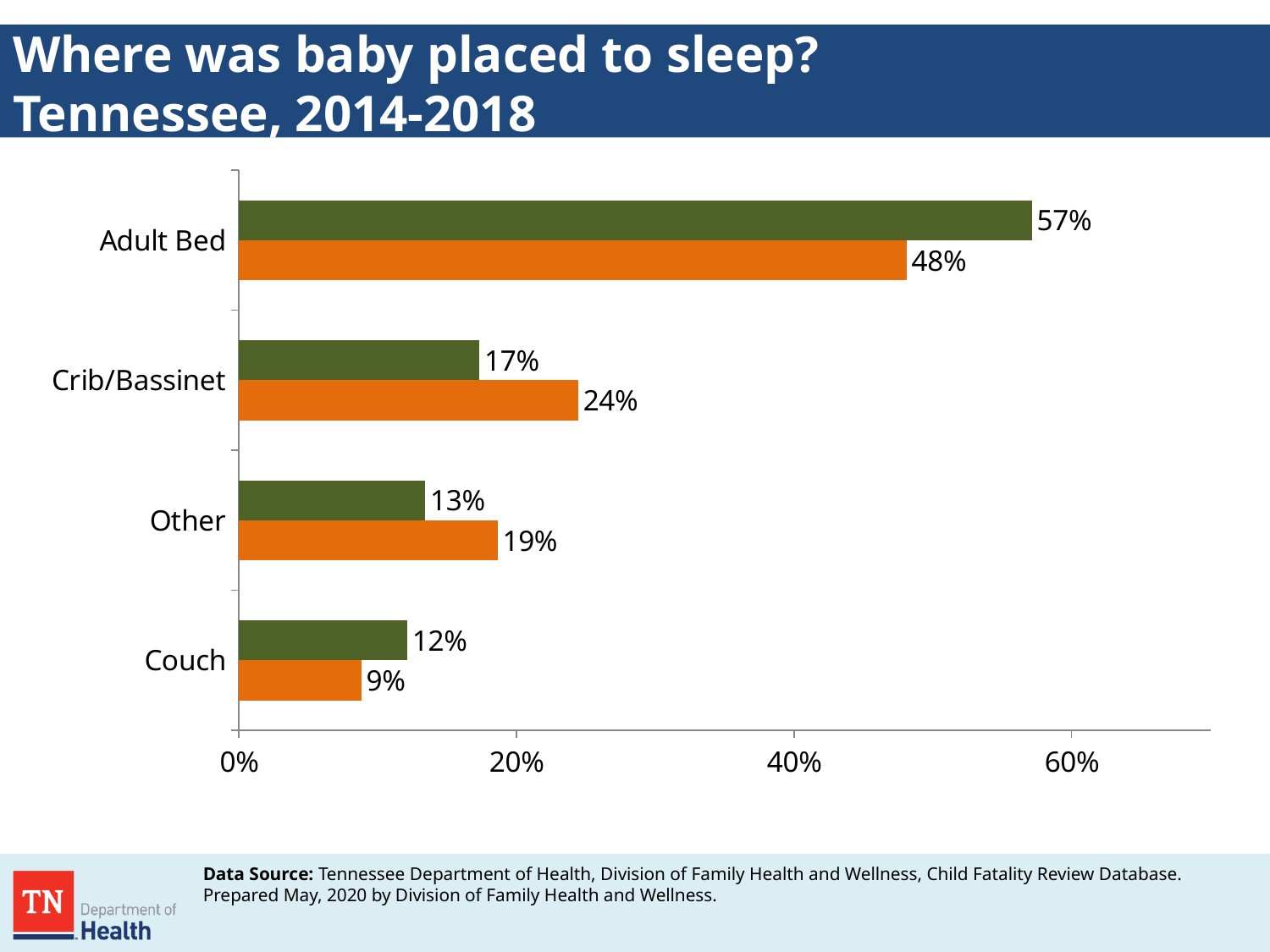
What kind of chart is shown on the slide? bar chart What is the value of the green bar for Other? 13% Is the orange bar for Adult Bed greater or less than 40%? greater Which category has the highest green bar? Adult Bed Which category has the lowest orange bar? Couch What is the value of the orange bar for Crib/Bassinet? 24% For Other, which bar is larger, the green or the orange? orange What is the value of the orange bar for Couch? 9% What is the value of the green bar for Adult Bed? 57% What is the difference between the orange and green bars for Crib/Bassinet? 7% How many categories are shown on the chart? 4 What is the difference between the green and orange bars for Adult Bed? 9%